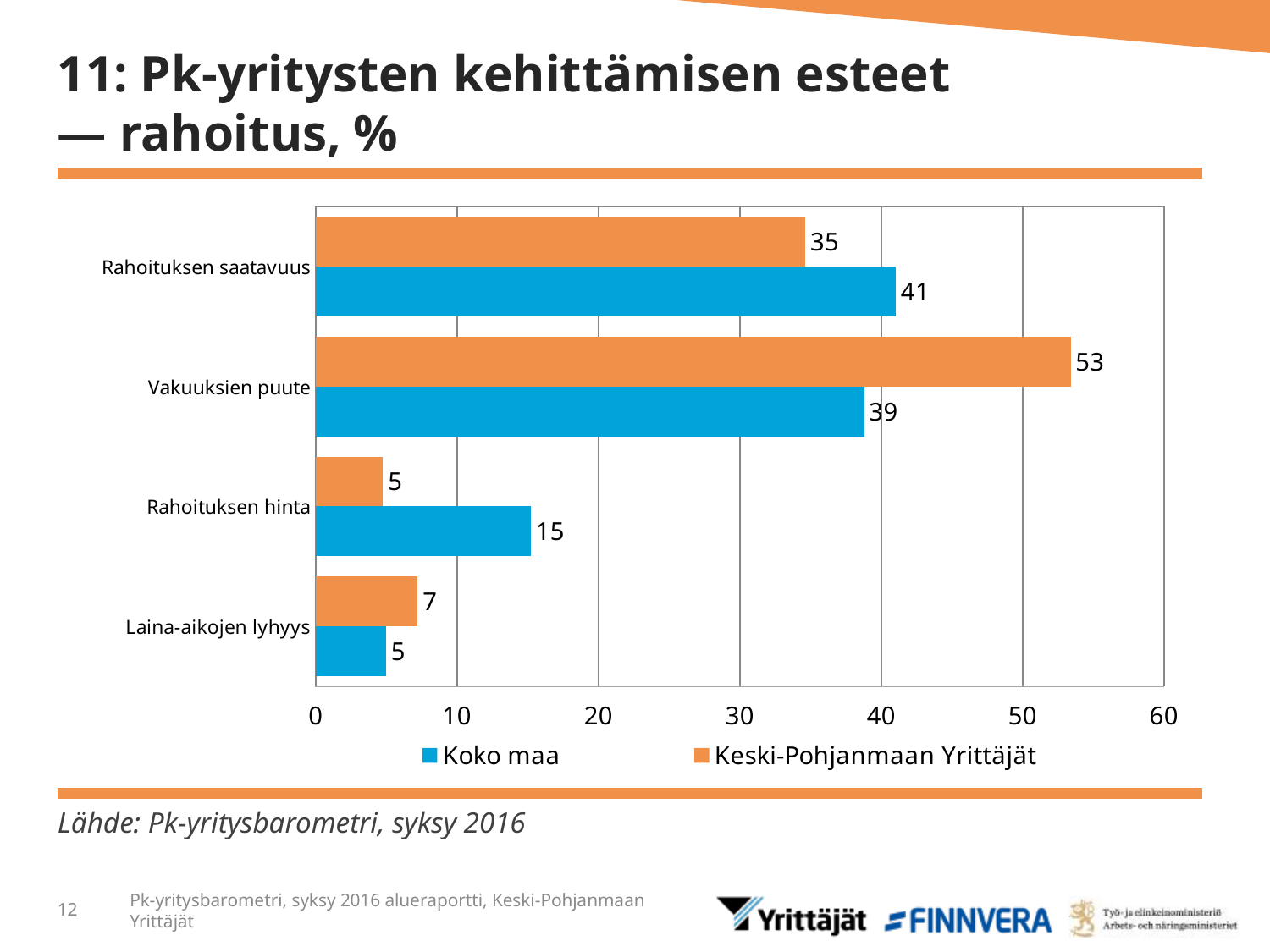
Which category has the lowest value for Koko maa? Laina-aikojen lyhyys What kind of chart is shown on the slide? Bar chart Which category has the highest value for Keski-Pohjanmaan Yrittäjät? Vakuuksien puute What is the difference between the Keski-Pohjanmaan Yrittäjät and Koko maa values for Vakuuksien puute? 14 What is the value for Koko maa for Rahoituksen hinta? 15 How many categories are shown on the chart? 4 How many series does the legend list? 2 For Rahoituksen saatavuus, which series has the larger value, Koko maa or Keski-Pohjanmaan Yrittäjät? Koko maa What is the value for Keski-Pohjanmaan Yrittäjät for Laina-aikojen lyhyys? 7 Which colour represents Koko maa in the chart? Blue What is the value for Koko maa for Rahoituksen saatavuus? 41 What is the value for Keski-Pohjanmaan Yrittäjät for Vakuuksien puute? 53